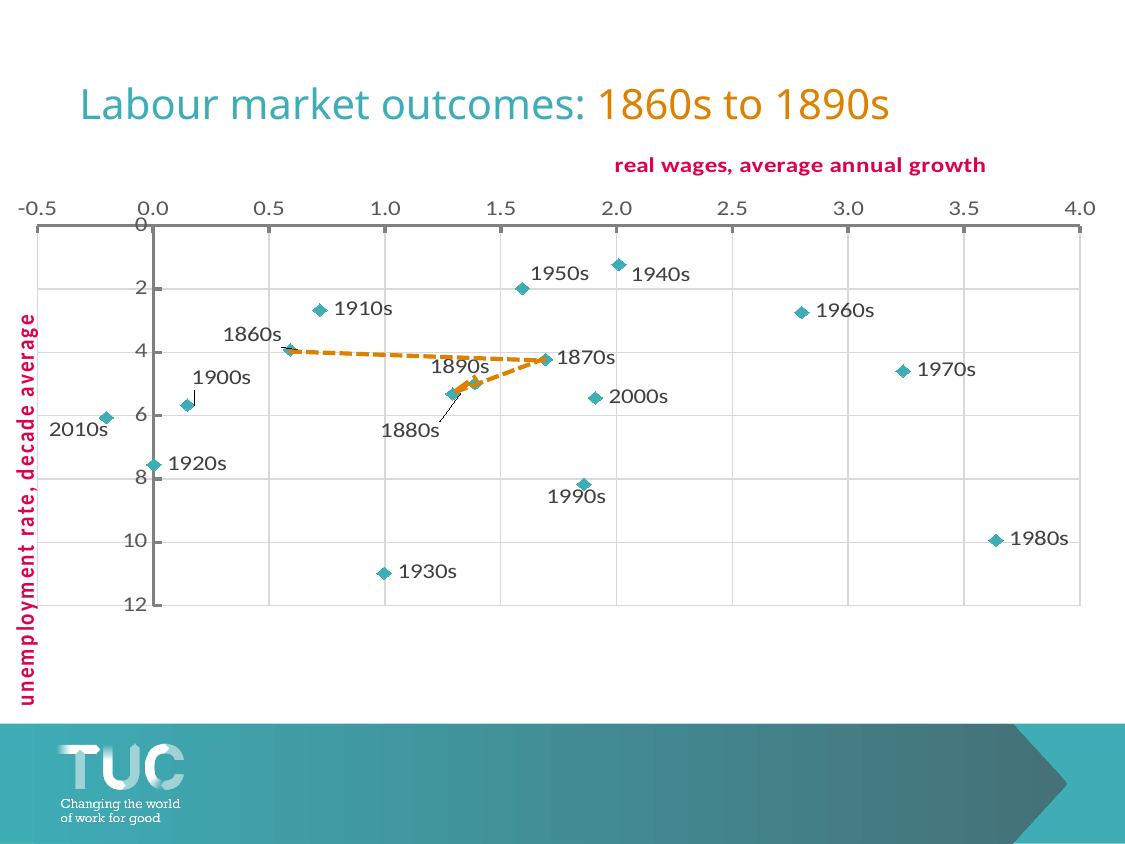
What is the label of the vertical axis of the chart? unemployment rate, decade average How many decades are plotted as points on the chart? 16 Is the real wages average annual growth for the 2010s greater or less than 0.0? less Which decade has the highest unemployment rate on the chart? 1930s Which decade has higher real wages average annual growth, the 1960s or the 1970s? 1970s What kind of chart is shown on the slide? scatter chart Which decade has the lowest unemployment rate on the chart? 1940s Which decade has the lowest real wages average annual growth? 2010s Is the real wages average annual growth for the 1980s greater or less than 3.5? greater Which decade has the highest real wages average annual growth? 1980s Which decade has a higher unemployment rate, the 1920s or the 1910s? 1920s Is the unemployment rate for the 1930s greater or less than 10? greater